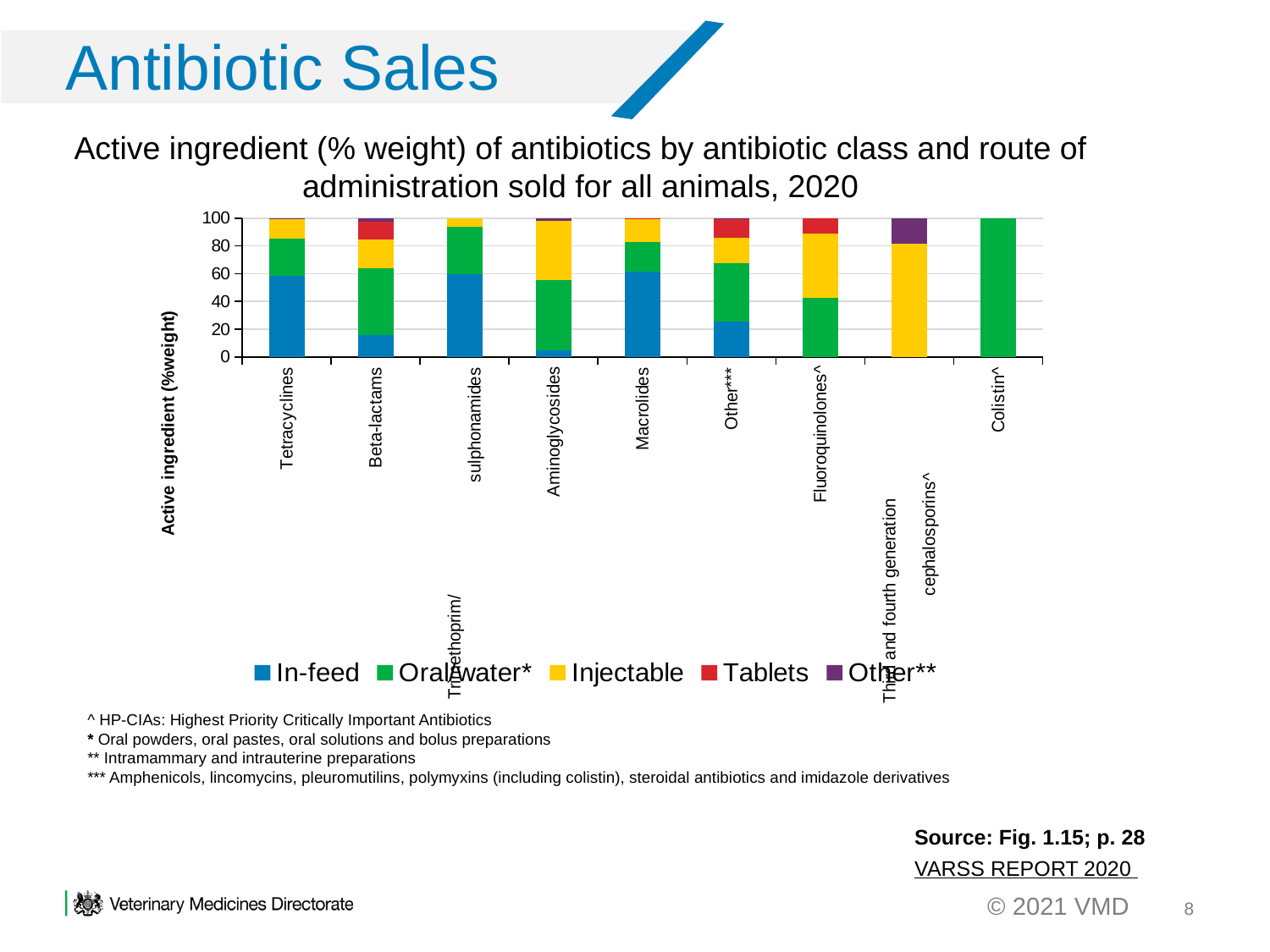
How many series does the chart legend list? 5 Which has the larger In-feed value, Tetracyclines or Beta-lactams? Tetracyclines Which antibiotic class has the largest Injectable share? Third and fourth generation cephalosporins^ How many antibiotic classes are shown along the x axis of the chart? 9 What is the Oral/water* value for Colistin^? 100 Is the In-feed value for Beta-lactams greater or less than 20? less Which route of administration accounts for the entire bar for Colistin^? Oral/water* What kind of chart is shown on the slide? Stacked bar chart Is the Injectable value for Third and fourth generation cephalosporins^ greater or less than 60? greater What is the label on the y axis of the chart? Active ingredient (%weight) Is the In-feed value for Tetracyclines greater or less than 40? greater